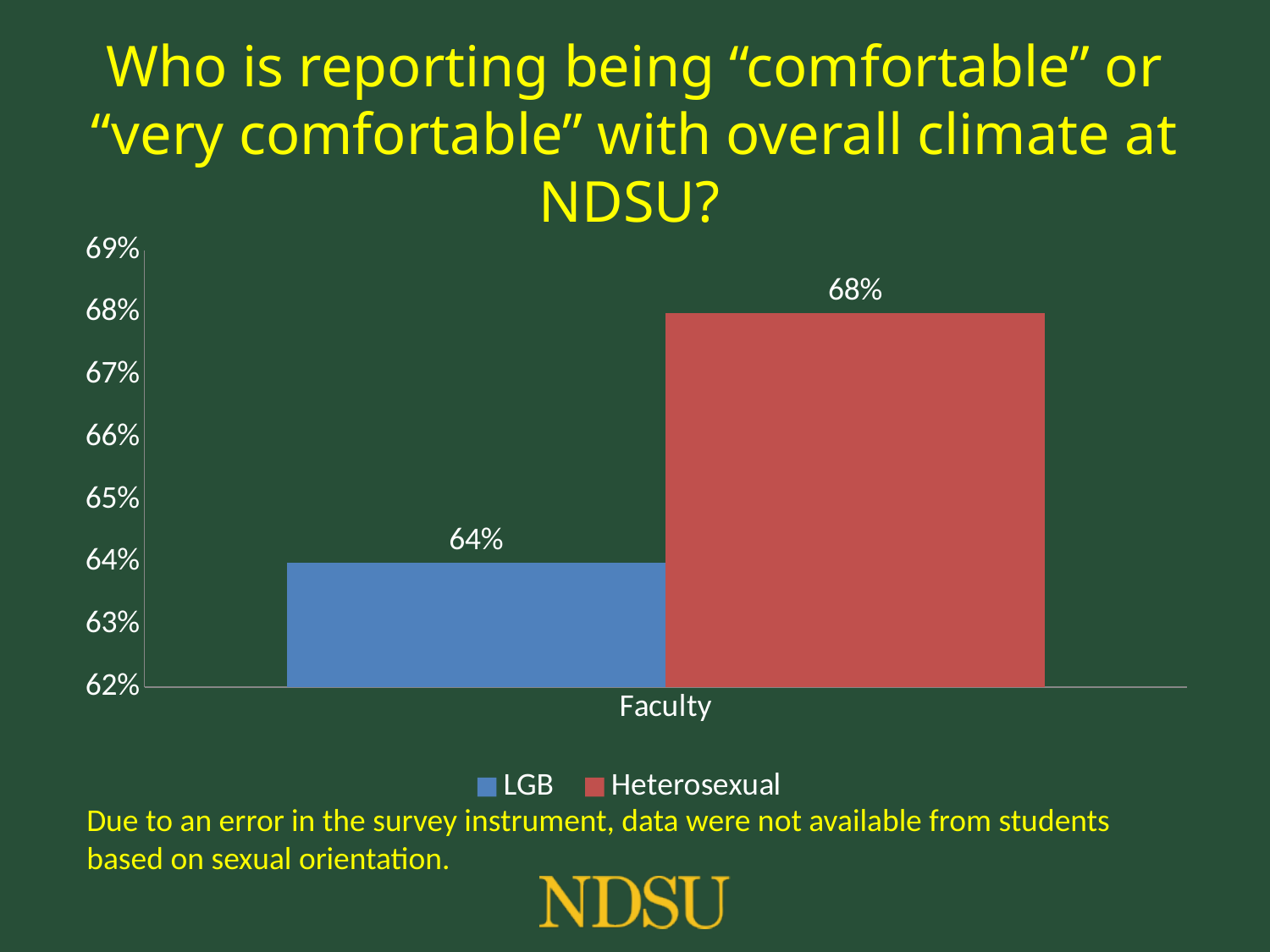
What is the difference between the Heterosexual and LGB values for Faculty? 4% Is the LGB value larger or smaller than the Heterosexual value? smaller What percentage of LGB faculty report being comfortable or very comfortable with the overall climate at NDSU? 64% How many categories are shown on the x axis? 1 What colour is the bar for the Heterosexual series? red What kind of chart is shown on the slide? bar chart Is the value for LGB greater or less than 65%? less Which series has the higher value for Faculty, LGB or Heterosexual? Heterosexual What percentage of Heterosexual faculty report being comfortable or very comfortable with the overall climate at NDSU? 68% How many series does the legend list? 2 Which series has the lower value for Faculty? LGB Is the value for Heterosexual greater or less than 66%? greater